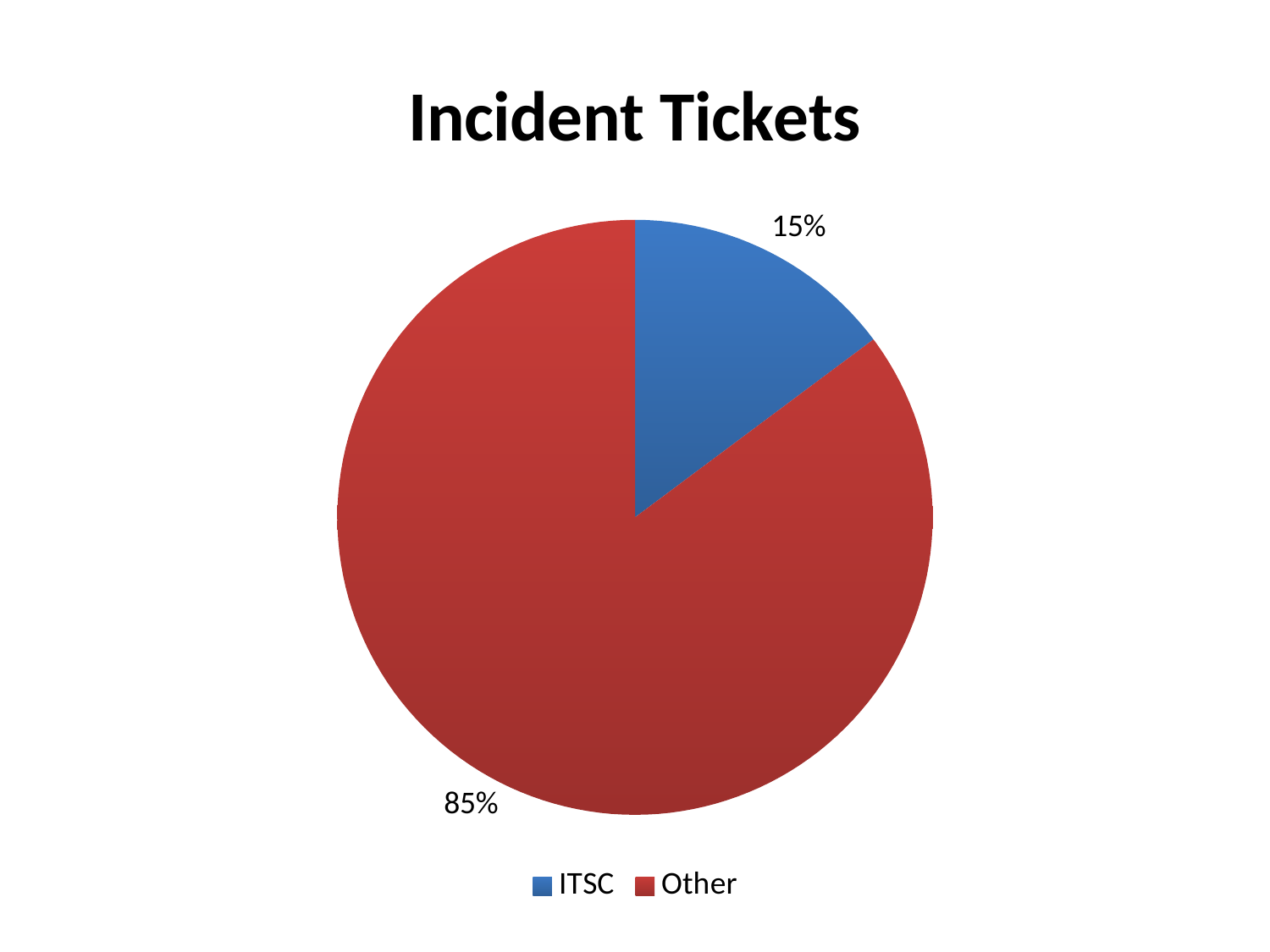
Which category has the largest slice of the pie? Other What is the difference in percentage points between the Other slice and the ITSC slice? 70 What share of incident tickets is Other? 85% What colour is the ITSC slice? blue What kind of chart is shown on the slide? pie chart How many entries does the legend list? 2 What share of incident tickets is ITSC? 15% What is the title of the chart? Incident Tickets How many slices does the pie chart have? 2 Which category has the smallest slice of the pie? ITSC Which is larger, the ITSC slice or the Other slice? Other